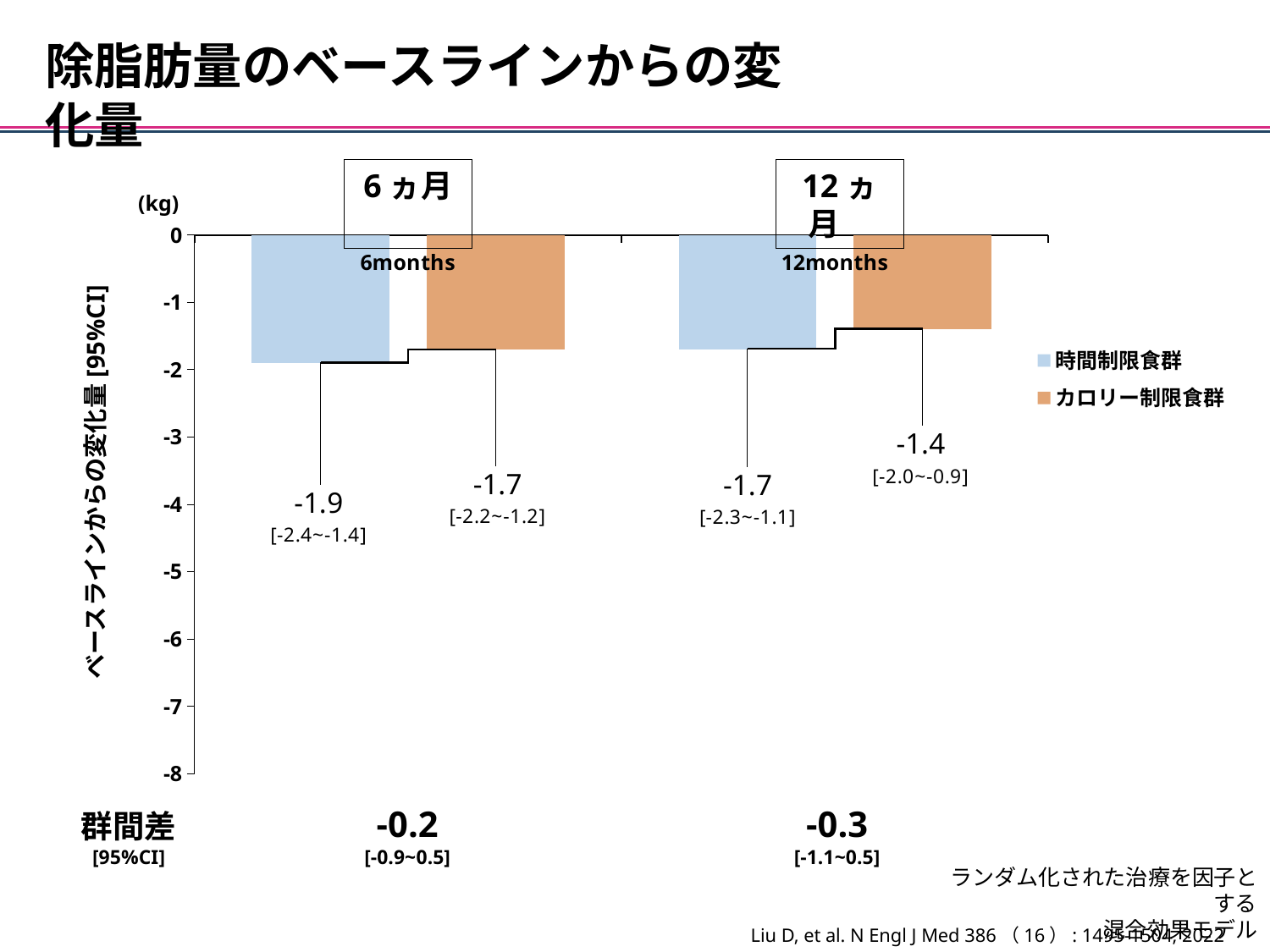
What unit is shown on the y axis of the chart? kg What is the difference between the 時間制限食群 and カロリー制限食群 values at 6months? 0.2 What is the 群間差 (between-group difference) shown at 12months? -0.3 Which group has the larger decrease at 12months, 時間制限食群 or カロリー制限食群? 時間制限食群 What is the value for the カロリー制限食群 at 12months? -1.4 What is the value for the 時間制限食群 at 6months? -1.9 What is the value for the 時間制限食群 at 12months? -1.7 How many series does the legend list? 2 What is the 95% confidence interval shown for the 時間制限食群 at 6months? [-2.4~-1.4] What is the value for the カロリー制限食群 at 6months? -1.7 Which bar shows the largest decrease from baseline? 時間制限食群 at 6months What kind of chart is shown on the slide? Bar chart